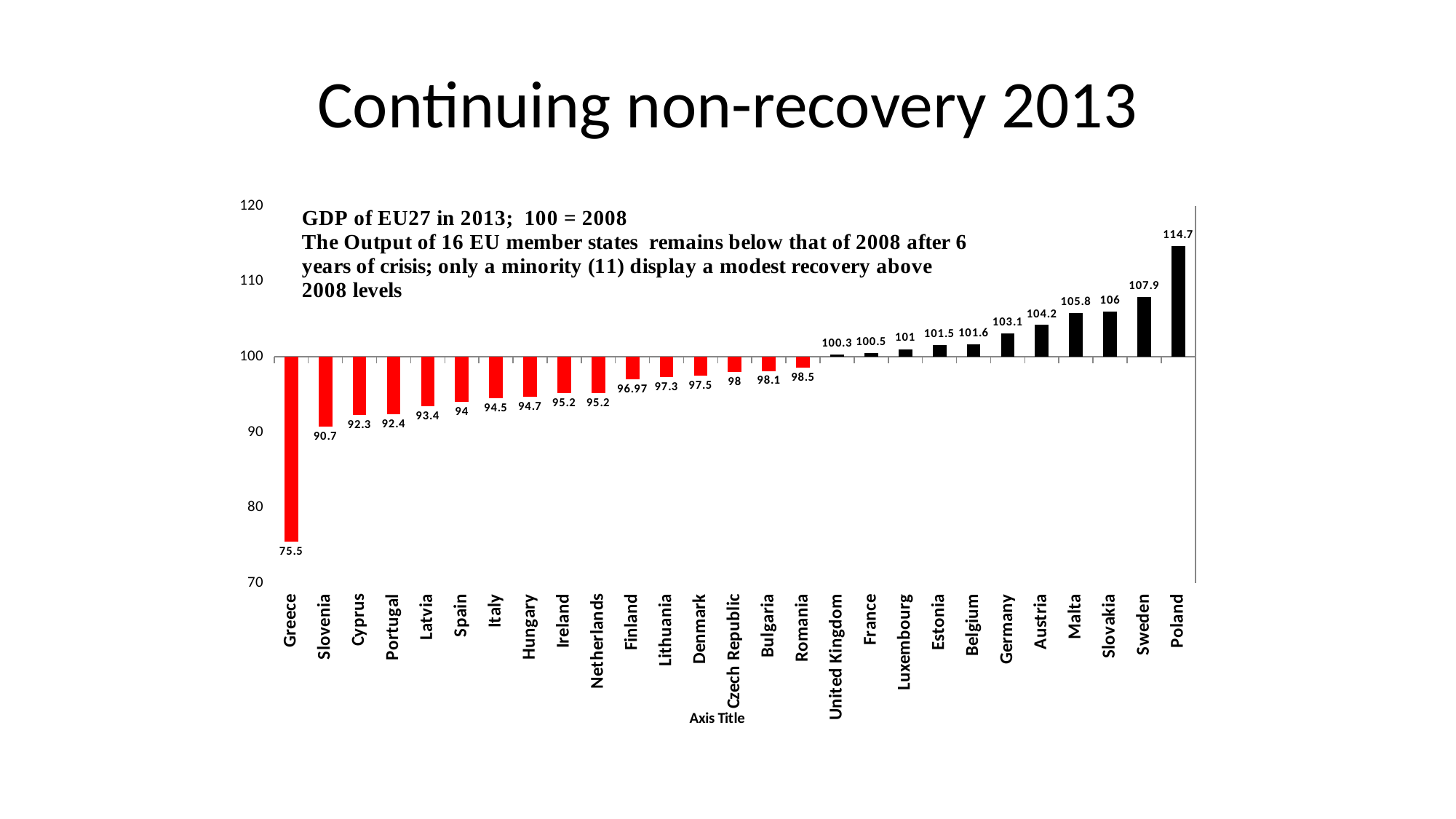
What is the value for Greece? 75.5 How many countries are shown on the chart? 27 What kind of chart is this? bar chart What is the value for Germany? 103.1 What colour are the bars for countries with values below 100? red Is the value for Slovenia greater or less than 100? less Which has a larger value, Sweden or Malta? Sweden What is the difference between the values for Poland and Greece? 39.2 What is the value for Finland? 96.97 Which country has the lowest value? Greece What is the value for Poland? 114.7 Which country has the highest value? Poland